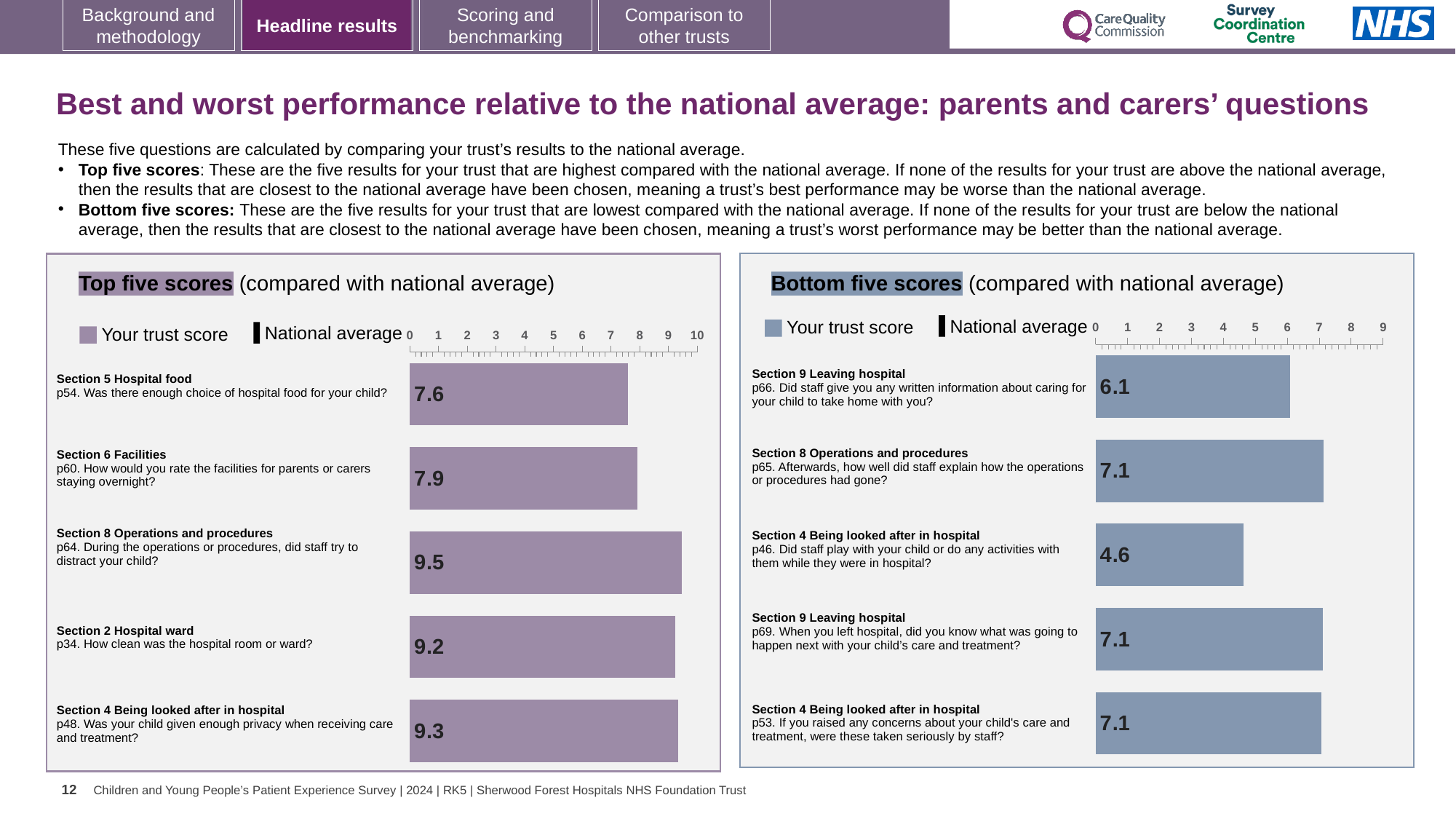
In the Bottom five scores chart, what is the difference between the trust scores for p65 and p46? 2.5 In the Top five scores chart, what is the trust score for p54 (Was there enough choice of hospital food for your child?)? 7.6 How many questions are plotted in the Bottom five scores chart? 5 In the Top five scores chart, which question has the lowest trust score? p54. Was there enough choice of hospital food for your child? In the Bottom five scores chart, is the trust score for p46 greater or less than 5? less How many entries does the legend of the Top five scores chart list? 2 In the Top five scores chart, what is the trust score for p34 (How clean was the hospital room or ward?)? 9.2 In the Bottom five scores chart, what is the trust score for p66 (Did staff give you any written information about caring for your child to take home with you?)? 6.1 In the Bottom five scores chart, which question has the lowest trust score? p46. Did staff play with your child or do any activities with them while they were in hospital? In the Top five scores chart, which question has the highest trust score? p64. During the operations or procedures, did staff try to distract your child? What kind of chart is the Top five scores chart? Bar chart In the Top five scores chart, what is the difference between the trust scores for p64 and p60? 1.6